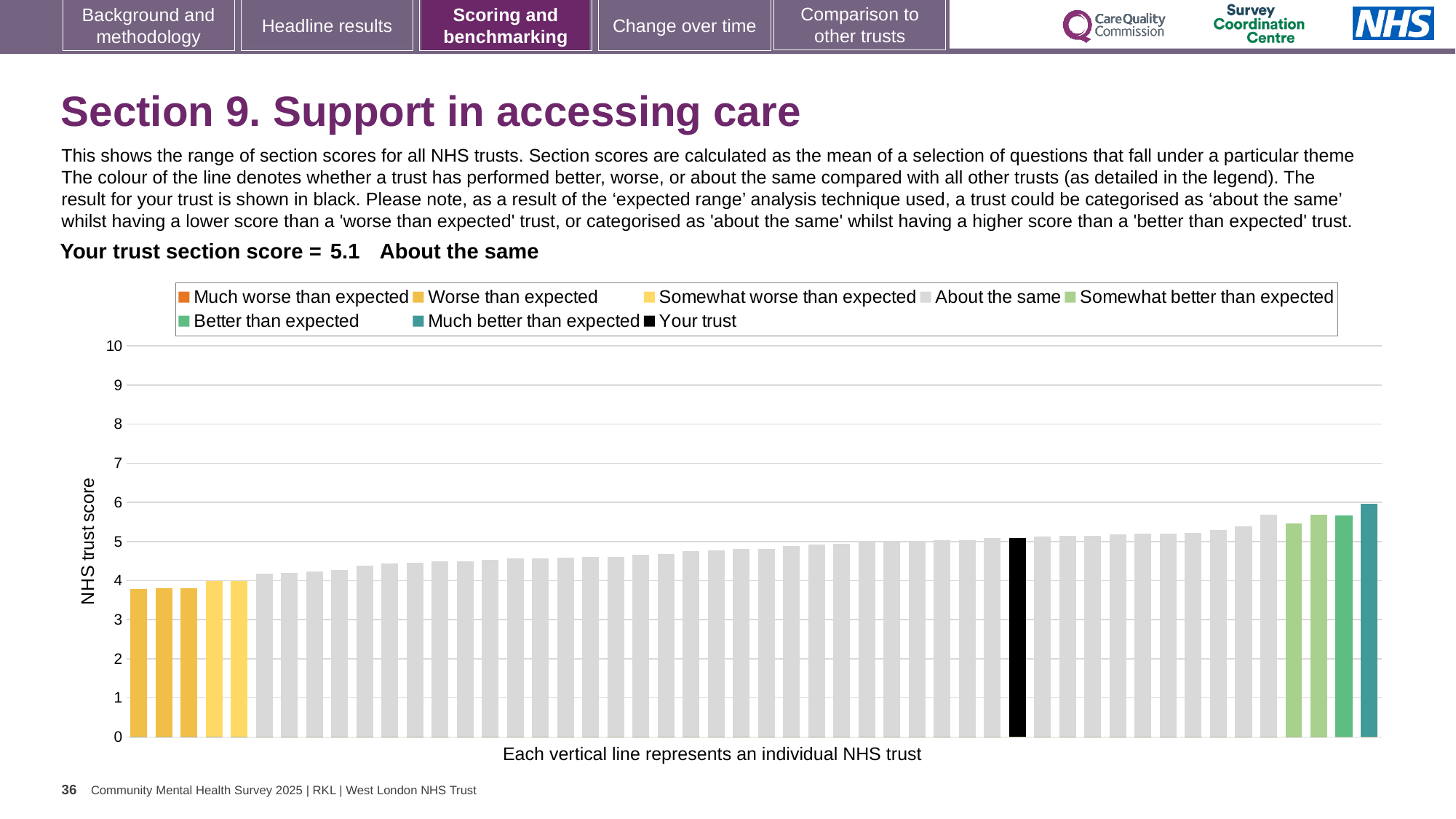
How many bars are coloured as 'Worse than expected'? 3 How many entries does the chart legend list? 8 Is the value for the black 'Your trust' bar greater or less than 5? greater What is the section score for your trust shown on the slide? 5.1 Is the value for the rightmost (highest) bar greater or less than 5? greater Is the value for the leftmost (lowest) bar greater or less than 4? less What kind of chart is shown on the slide? bar chart Do the bar values rise or fall from left to right along the x axis? rise Which performance category is your trust placed in for this section? About the same How many bars are coloured as 'Somewhat worse than expected'? 2 How many bars are coloured as 'Much better than expected'? 1 What is the label on the vertical axis of the chart? NHS trust score